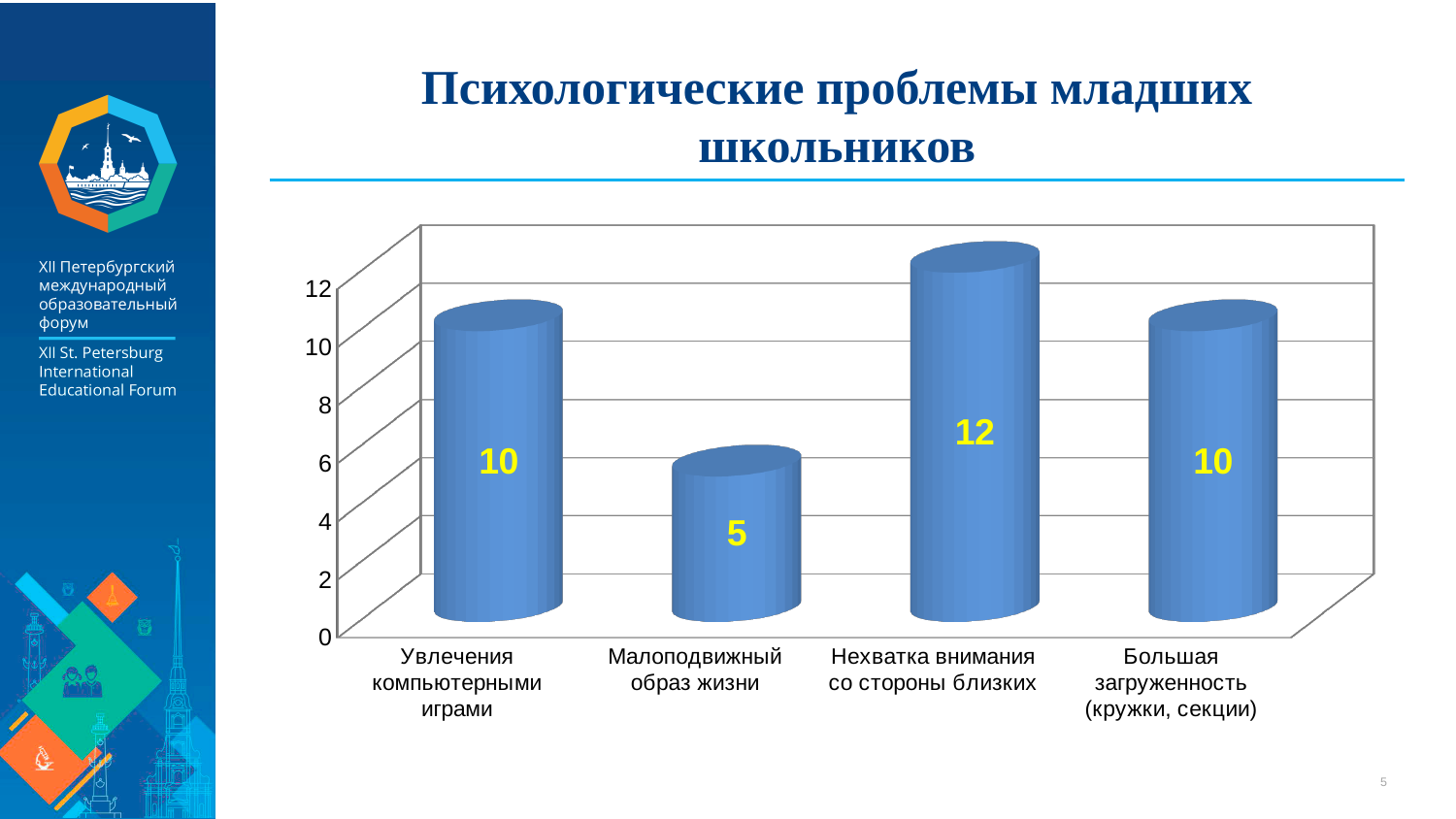
What is the value for "Нехватка внимания со стороны близких"? 12 What is the value for "Большая загруженность (кружки, секции)"? 10 Which category has the lowest value? Малоподвижный образ жизни Which category has the highest value? Нехватка внимания со стороны близких What is the value for "Увлечения компьютерными играми"? 10 What is the difference between the values for "Нехватка внимания со стороны близких" and "Большая загруженность (кружки, секции)"? 2 What is the title of the slide containing the chart? Психологические проблемы младших школьников What is the difference between the values for "Нехватка внимания со стороны близких" and "Малоподвижный образ жизни"? 7 Which is larger: the value for "Увлечения компьютерными играми" or the value for "Малоподвижный образ жизни"? Увлечения компьютерными играми What kind of chart is shown on the slide? Bar chart What is the value for "Малоподвижный образ жизни"? 5 How many categories are shown on the chart? 4